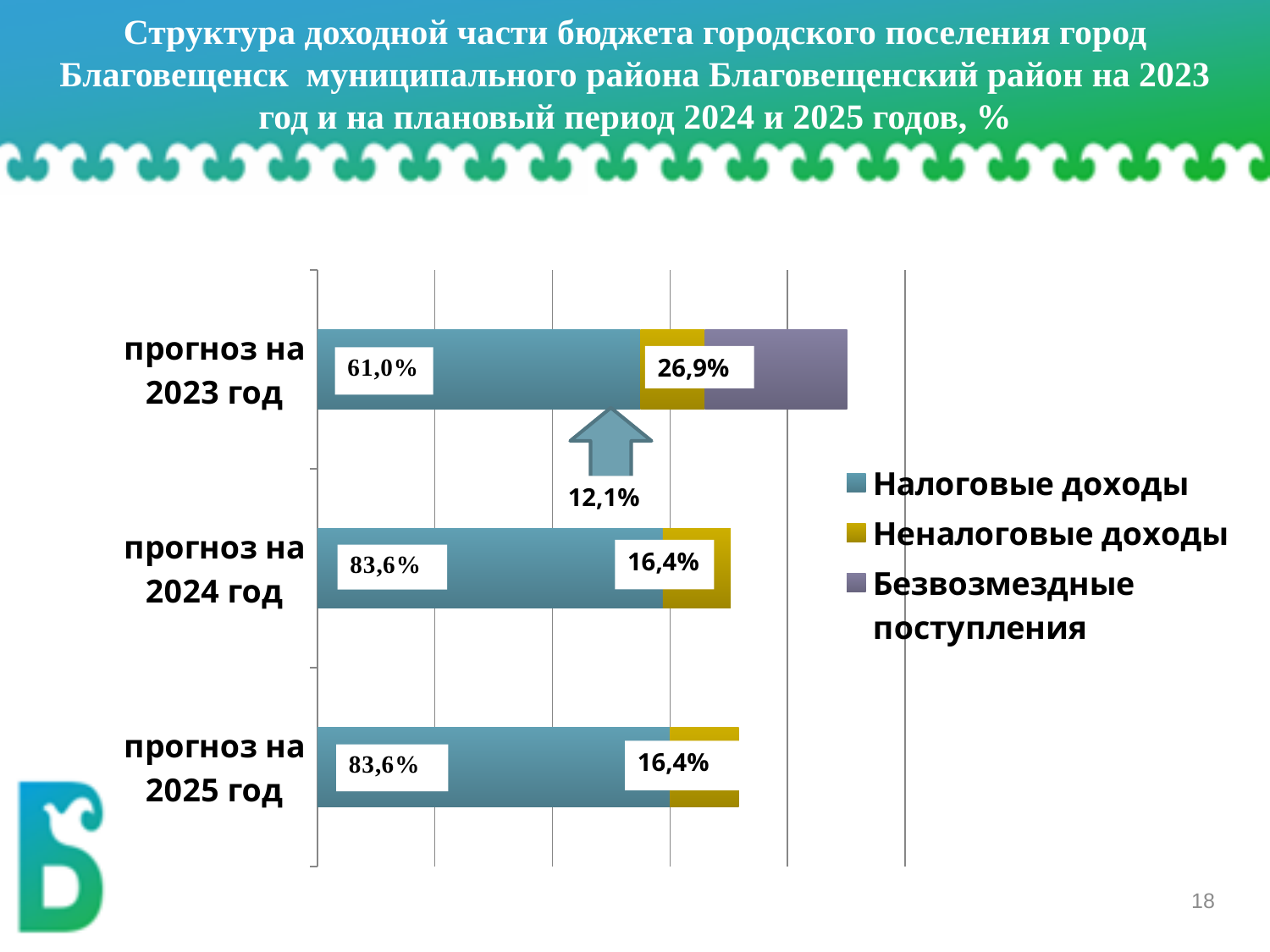
How many forecast years (categories) are shown in the chart? 3 What is the value of Безвозмездные поступления for прогноз на 2023 год? 26,9% What is the difference between the Налоговые доходы share for прогноз на 2024 год and прогноз на 2023 год? 22,6% Which is larger: Неналоговые доходы for прогноз на 2024 год or Безвозмездные поступления for прогноз на 2023 год? Безвозмездные поступления for прогноз на 2023 год What is the value of Налоговые доходы for прогноз на 2023 год? 61,0% In which forecast year is the share of Налоговые доходы the lowest? прогноз на 2023 год What is the value of Налоговые доходы for прогноз на 2024 год? 83,6% What value does the arrow point to for Неналоговые доходы in прогноз на 2023 год? 12,1% How many series does the legend list? 3 Which legend entry is shown in purple? Безвозмездные поступления What is the value of Неналоговые доходы for прогноз на 2025 год? 16,4% What kind of chart is shown on the slide? Stacked bar chart